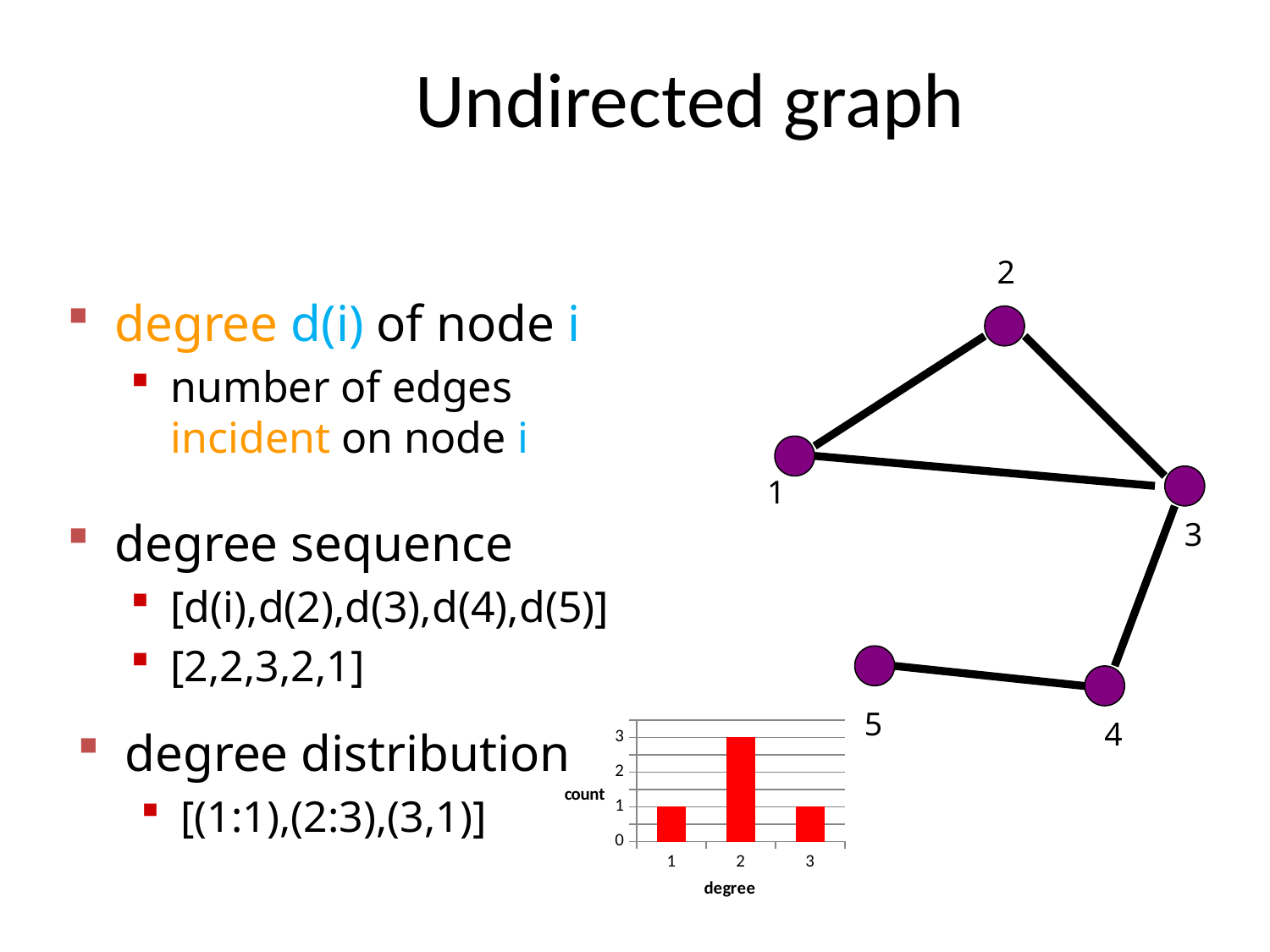
What is the label of the x axis of the bar chart? degree What kind of chart is shown at the bottom of the slide? bar chart In the bar chart, what is the difference between the count for degree 2 and the count for degree 1? 2 In the bar chart, is the count for degree 2 greater or less than 2? greater In the bar chart, what is the count for degree 2? 3 Which degree has the highest count in the bar chart? 2 How many degree categories are shown on the x axis of the bar chart? 3 What is the label of the y axis of the bar chart? count In the bar chart, is the count for degree 2 larger than the count for degree 3? yes In the bar chart, what is the count for degree 3? 1 In the bar chart, what is the total of the counts across all three degrees? 5 In the bar chart, what is the count for degree 1? 1